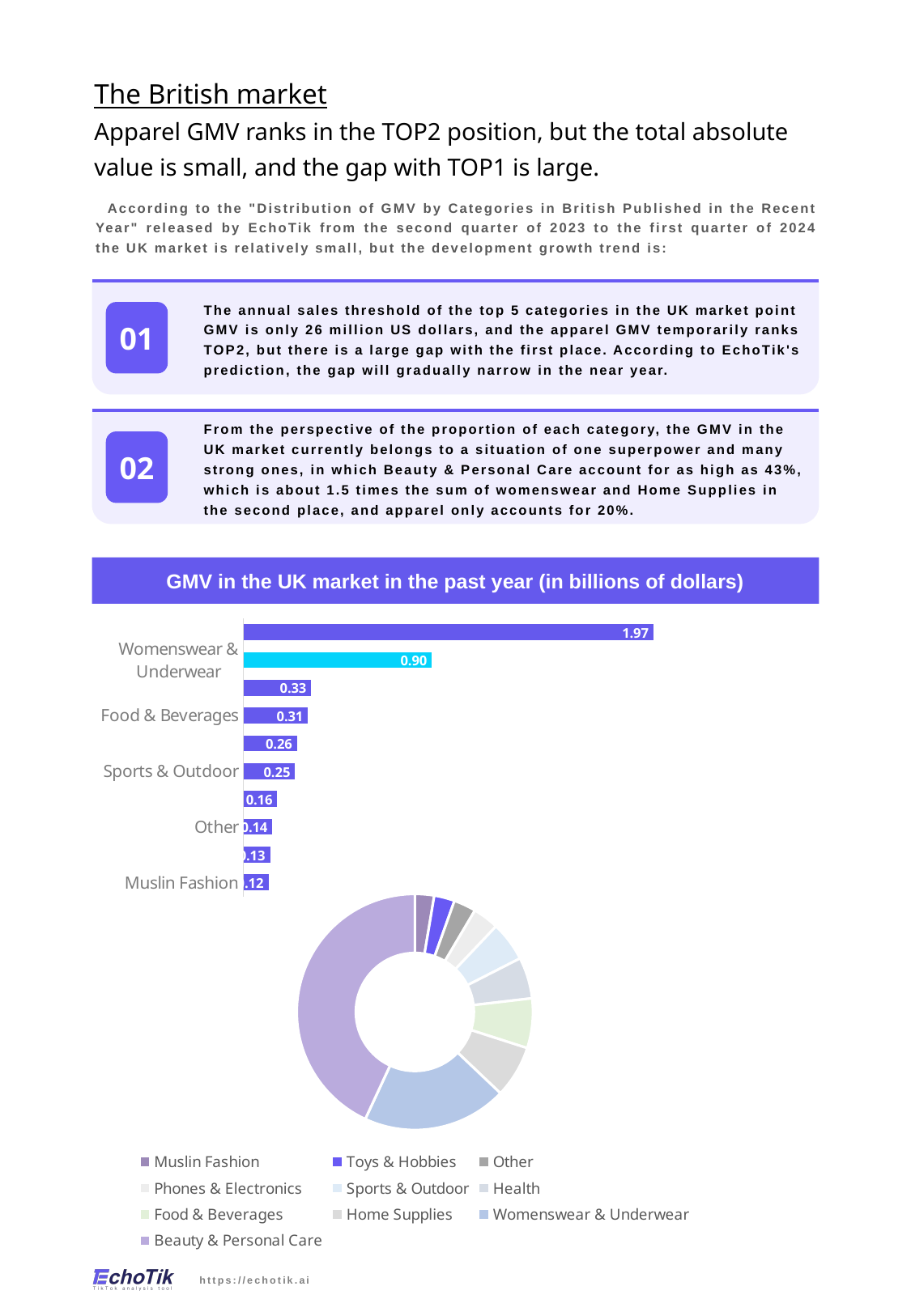
In the bar chart "GMV in the UK market in the past year", what is the difference between the values for Womenswear & Underwear and Food & Beverages? 0.59 How many bars are plotted in the bar chart "GMV in the UK market in the past year"? 10 In the bar chart "GMV in the UK market in the past year", what is the value for Food & Beverages? 0.31 In the bar chart "GMV in the UK market in the past year", which is larger: the value for Sports & Outdoor or the value for Other? Sports & Outdoor In the doughnut chart at the bottom of the slide, which category has the largest slice? Beauty & Personal Care In the bar chart "GMV in the UK market in the past year", what is the value for Sports & Outdoor? 0.25 In the bar chart "GMV in the UK market in the past year", what is the value for Muslin Fashion? 0.12 How many categories does the legend of the doughnut chart at the bottom of the slide list? 10 In the bar chart "GMV in the UK market in the past year", what is the value for Other? 0.14 In the bar chart "GMV in the UK market in the past year", what is the largest value shown on any bar? 1.97 In the bar chart "GMV in the UK market in the past year", what is the value for Womenswear & Underwear? 0.90 What kind of chart is the chart titled "GMV in the UK market in the past year (in billions of dollars)"? bar chart